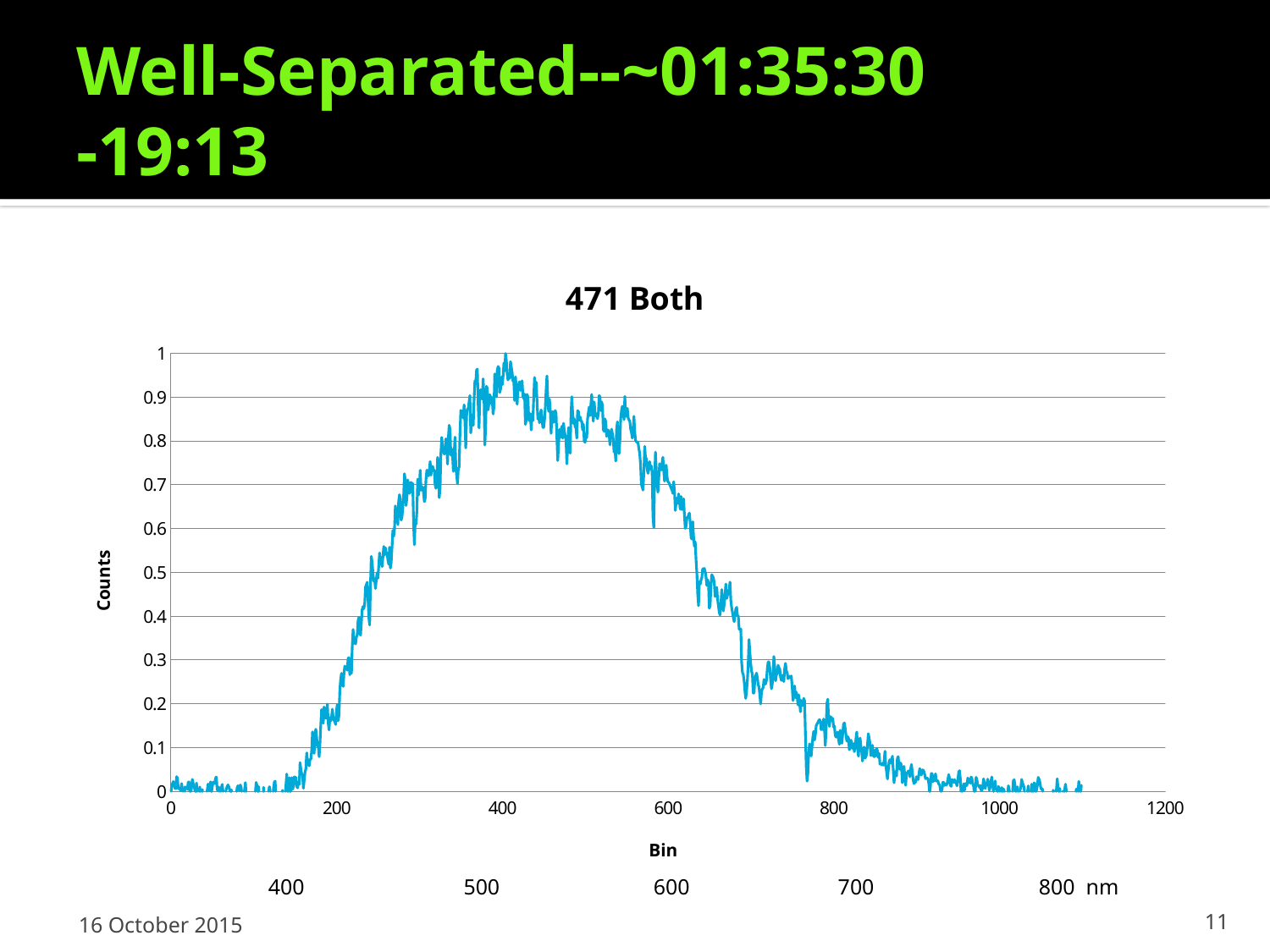
Is the value at bin 800 greater or less than 0.3? less Is the value at bin 400 greater or less than 0.9? greater What is the label of the vertical axis of the chart? Counts How many data series are plotted on the chart? 1 Do the values rise or fall along the x axis between bin 200 and bin 400? rise Is the value at bin 600 greater or less than 0.5? greater What kind of chart is shown on the slide? line chart What is the title of the chart? 471 Both Do the values rise or fall along the x axis between bin 600 and bin 1000? fall